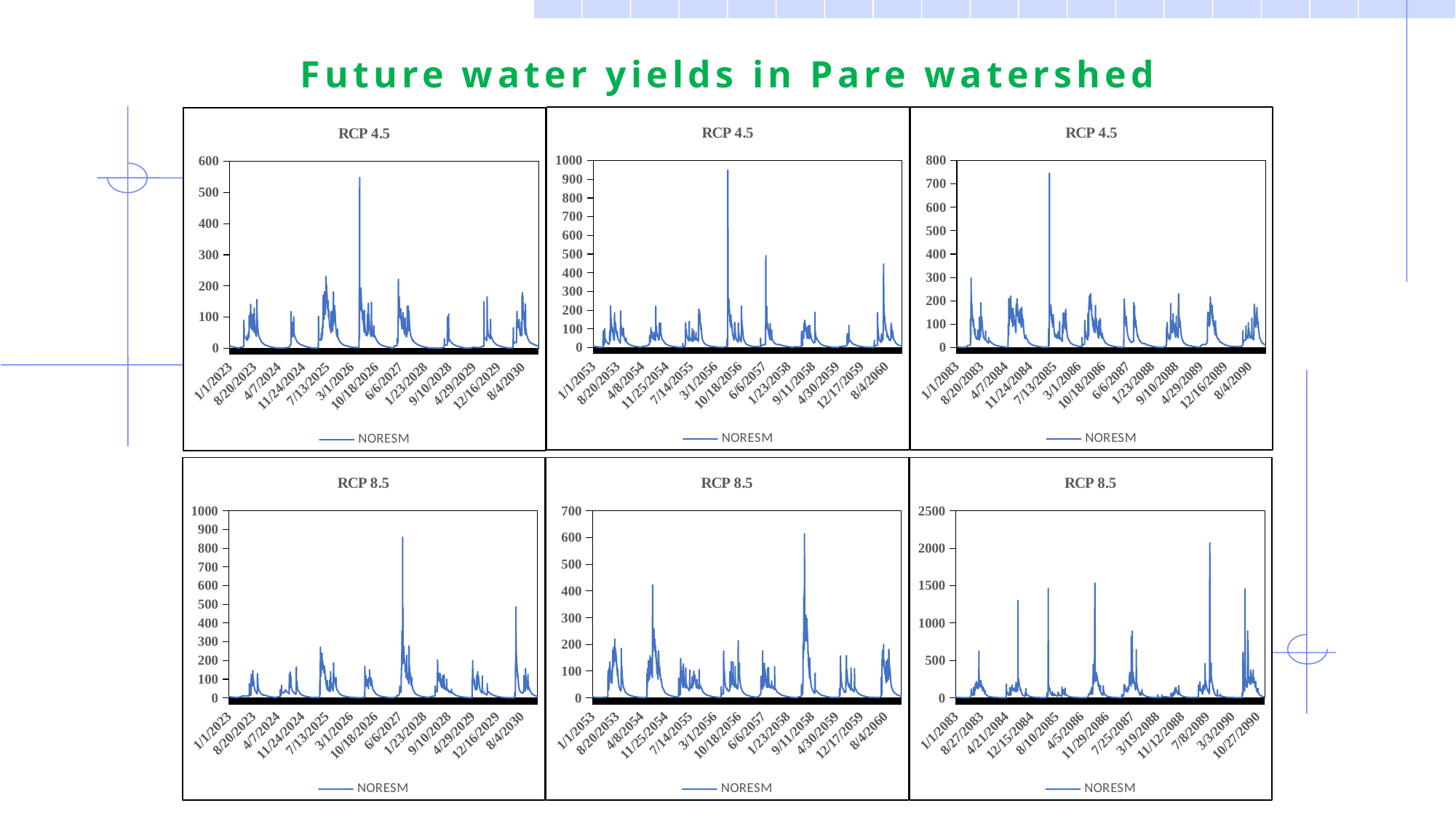
In the bottom-left RCP 8.5 chart, is the highest peak greater or less than 800? greater In the bottom-middle RCP 8.5 chart, is the highest peak greater or less than 500? greater What is the name of the series shown in the legend of the top-middle RCP 4.5 chart? NORESM What is the maximum value shown on the y-axis of the bottom-right RCP 8.5 chart? 2500 In the bottom-right RCP 8.5 chart, is the highest peak greater or less than 2000? greater How many charts are shown on the slide? 6 What kind of chart is the top-left chart titled RCP 4.5? line chart How many series does the legend of the bottom-right RCP 8.5 chart list? 1 Which chart has the higher maximum y-axis value: the top-left RCP 4.5 chart or the bottom-left RCP 8.5 chart? bottom-left RCP 8.5 chart